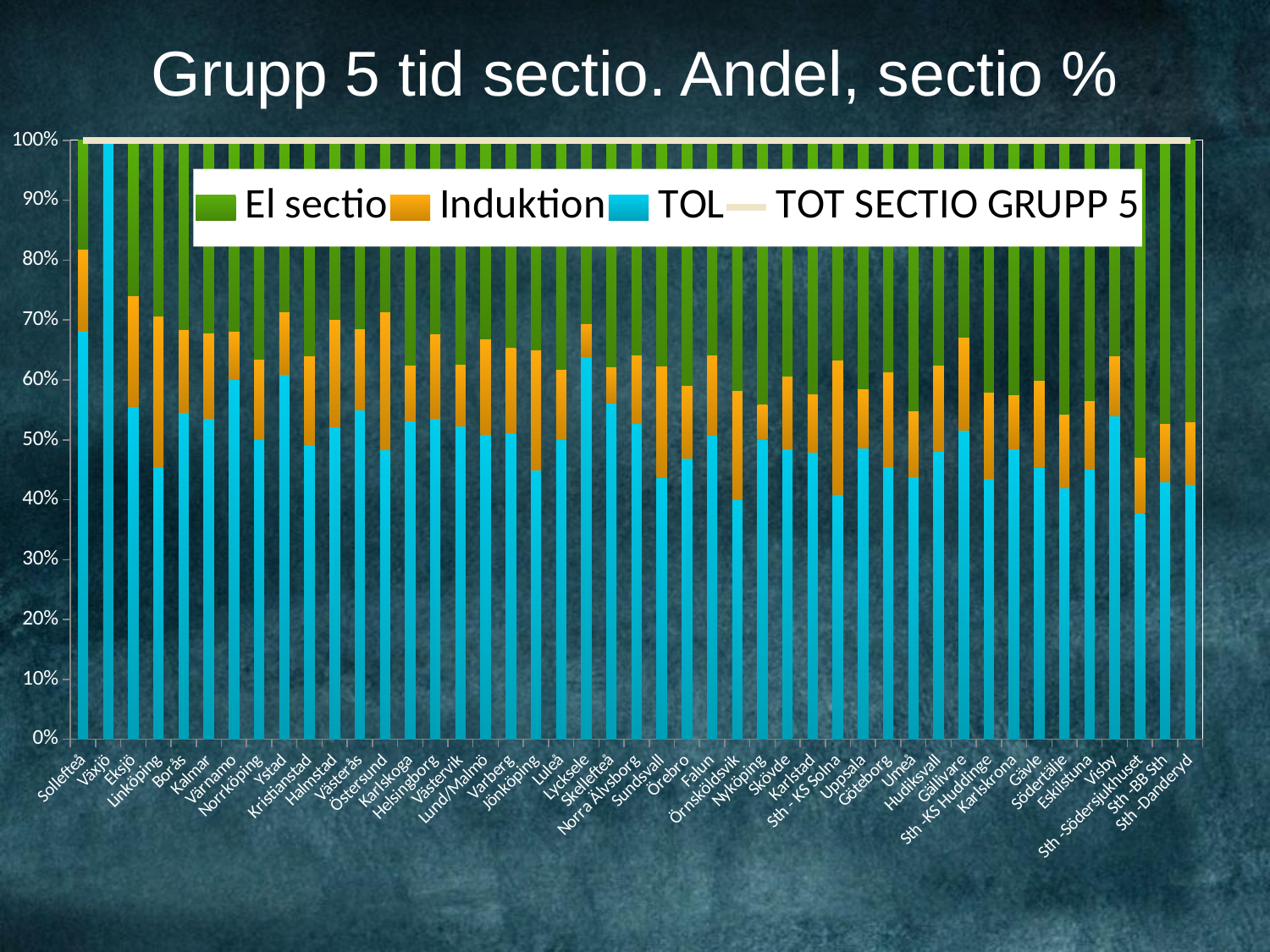
How many hospitals (categories) are shown along the x axis? 45 Which has the larger TOL share, Sollefteå or Sth -Danderyd? Sollefteå Is the TOL value for Sth -Danderyd greater or less than 50%? less Which hospital has the highest TOL share? Växjö How many entries does the chart legend list? 4 Which series is shown in blue in the chart? TOL What kind of chart is shown on the slide? Combination stacked bar and line chart Is the TOL value for Sth -Södersjukhuset greater or less than 40%? less Is the TOL value for Växjö greater or less than 90%? greater What is the title of the chart? Grupp 5 tid sectio. Andel, sectio % Which has the larger TOL share, Växjö or Eksjö? Växjö